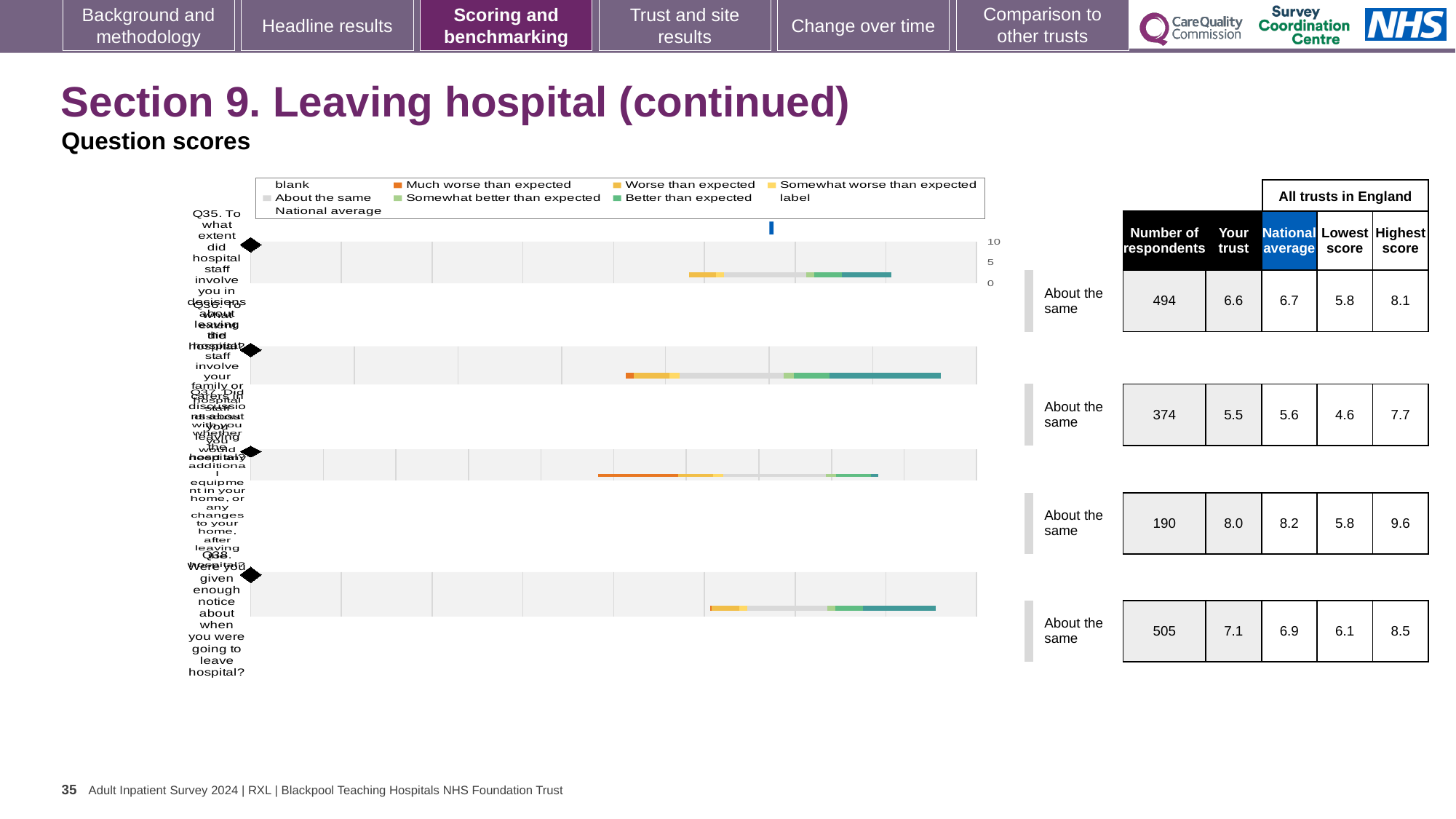
How many question rows are plotted in the chart? 4 What kind of chart is used to show the question scores on this slide? bar chart Which question row has the lowest number of respondents? the third row (190) For the first question row, what is the difference between the highest score and the lowest score across all trusts in England? 2.3 Which question row has the highest 'Your trust' score? the third row (8.0) What benchmark category is shown for all four question rows? About the same What is the national average score for the second question row? 5.6 Is the 'Your trust' score for the second question row greater or less than 6? less What is the 'Your trust' score for the fourth question row (Q38, about being given enough notice about leaving hospital)? 7.1 In the table next to the chart, what is the number of respondents for the first question row (Q35)? 494 For the third question row, how much higher is the national average than the 'Your trust' score? 0.2 For the fourth question row, which is larger: the 'Your trust' score or the national average? Your trust (7.1)